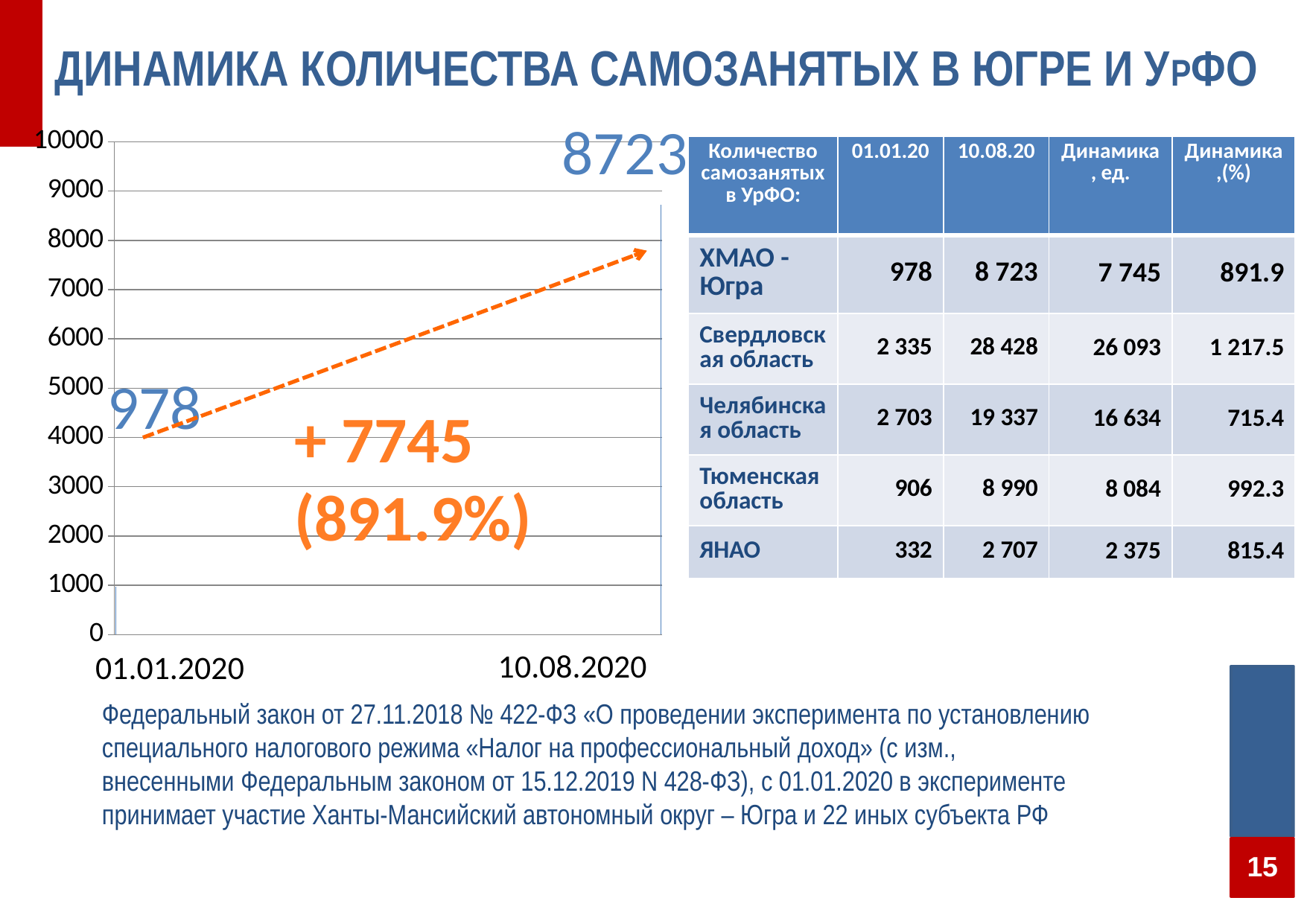
Is the value for 10.08.2020 greater or less than 5000? greater Which date on the chart has the lowest value? 01.01.2020 What percentage growth is printed on the chart next to the increase of 7745? 891.9% By how much did the number of self-employed increase between 01.01.2020 and 10.08.2020 according to the chart? 7745 How many dates are plotted on the chart's x axis? 2 What is the highest tick value shown on the chart's y axis? 10000 Which date has the larger value on the chart, 01.01.2020 or 10.08.2020? 10.08.2020 What is the number of self-employed shown for 10.08.2020 on the chart? 8723 Which date on the chart has the highest value? 10.08.2020 Do the values on the chart rise or fall from 01.01.2020 to 10.08.2020? rise What is the number of self-employed shown for 01.01.2020 on the chart? 978